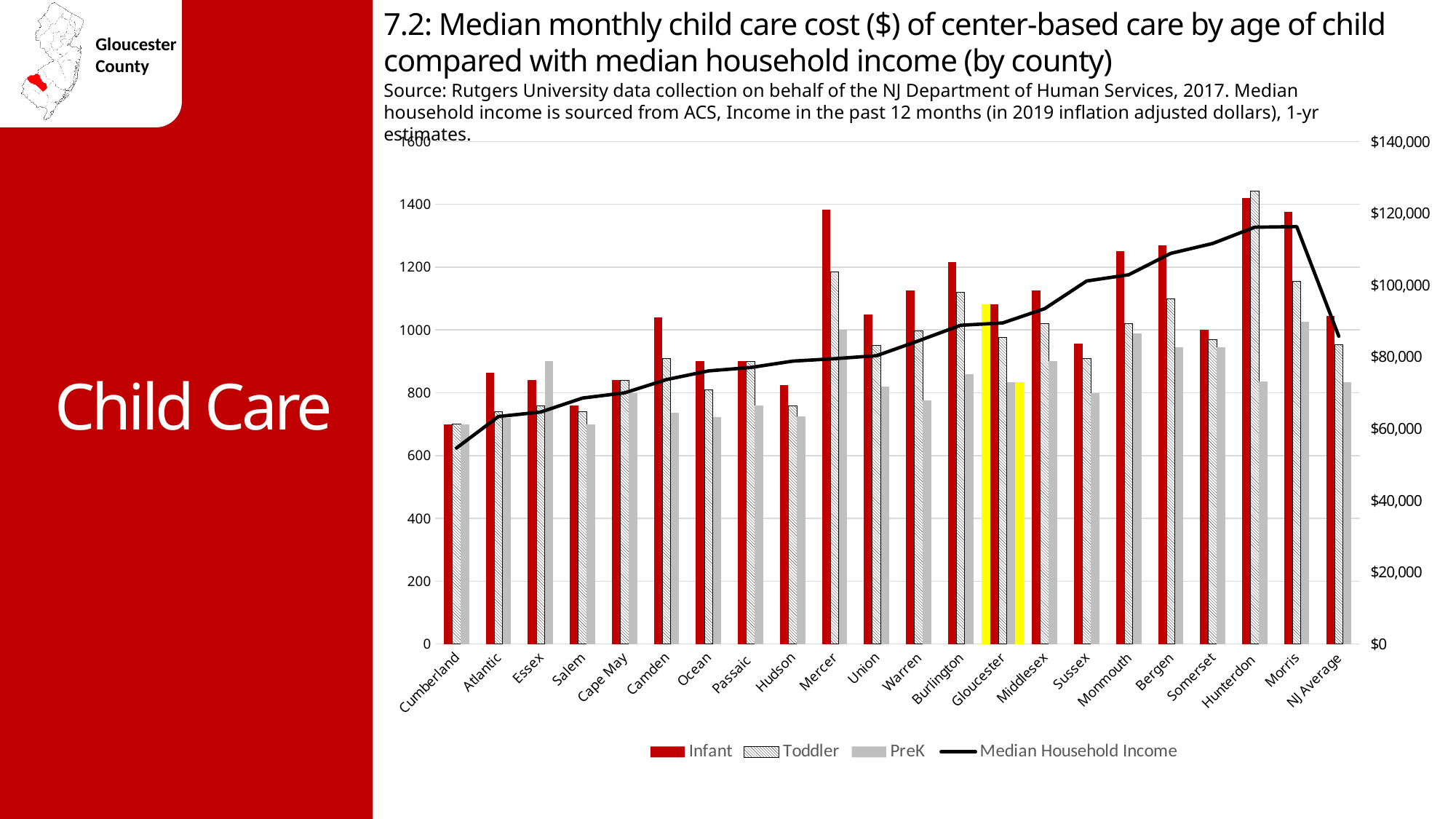
Is the Infant value for Mercer greater or less than 1200? greater Which category has the lowest Infant value? Cumberland Is the Median Household Income for Hunterdon greater or less than $100,000? greater Does the Median Household Income line rise or fall from Cumberland to Morris? rise Which category has the highest Toddler value? Hunterdon What kind of chart is shown on the slide? Bar chart with a line How many categories are shown along the x axis? 22 Is the Infant value for Cumberland greater or less than 800? less Which county's bars are highlighted in yellow? Gloucester Which is larger, the Infant value for Mercer or the Infant value for Camden? Mercer How many series does the legend list? 4